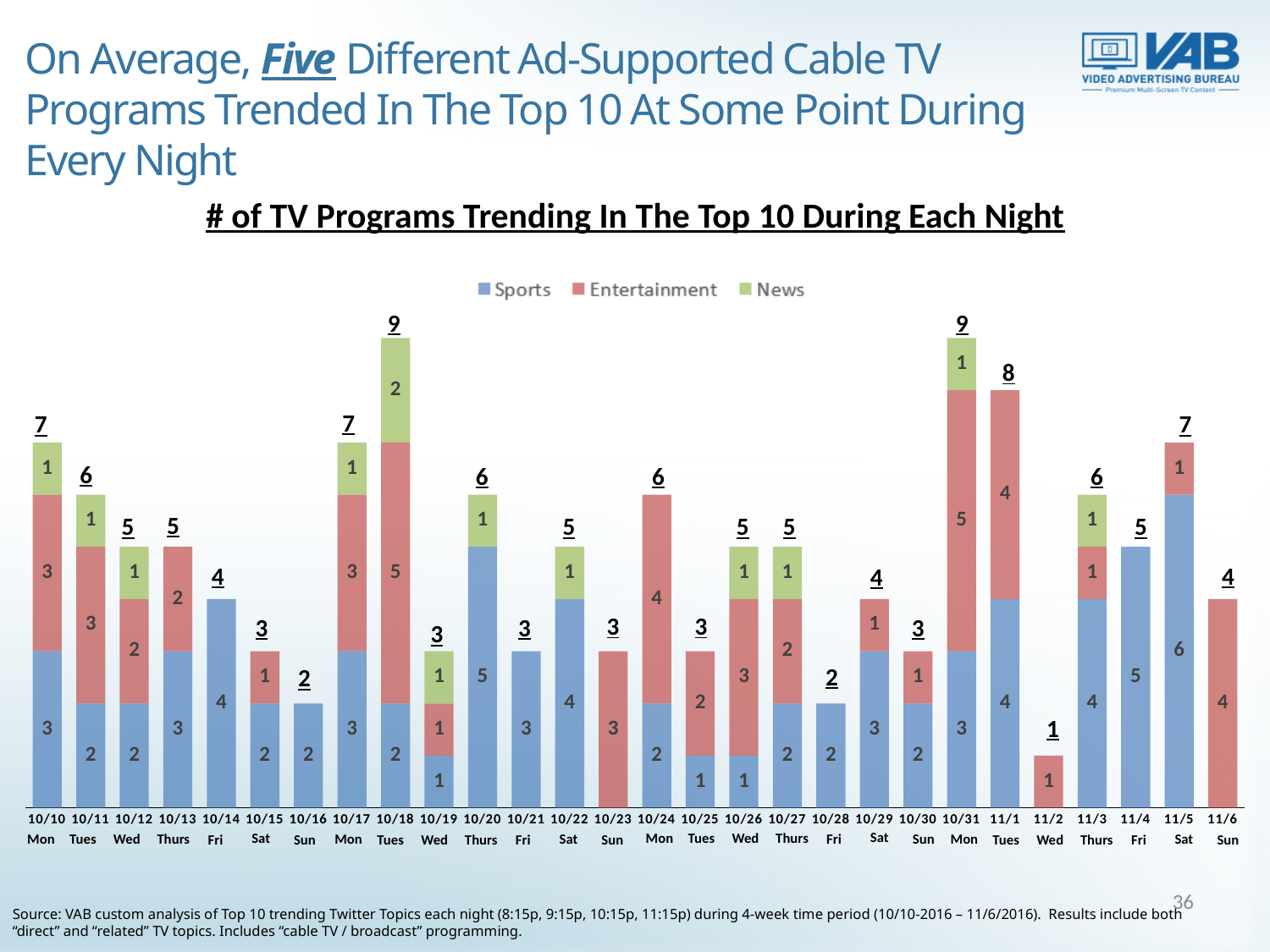
How many series does the legend list? 3 What is the News value for 10/18? 2 Which night has the lowest total number of trending TV programs? 11/2 (Wed) Which series is shown in green? News Which is larger, the total for 10/24 or the total for 10/25? 10/24 What is the Sports value for 11/5? 6 How many nights (bars) are shown on the chart? 28 What is the total number of TV programs trending on 10/18? 9 What is the Entertainment value for 10/31? 5 What is the Sports value for 10/20? 5 What kind of chart is shown on the slide? Stacked bar chart What is the difference between the total for 11/1 and the total for 11/2? 7